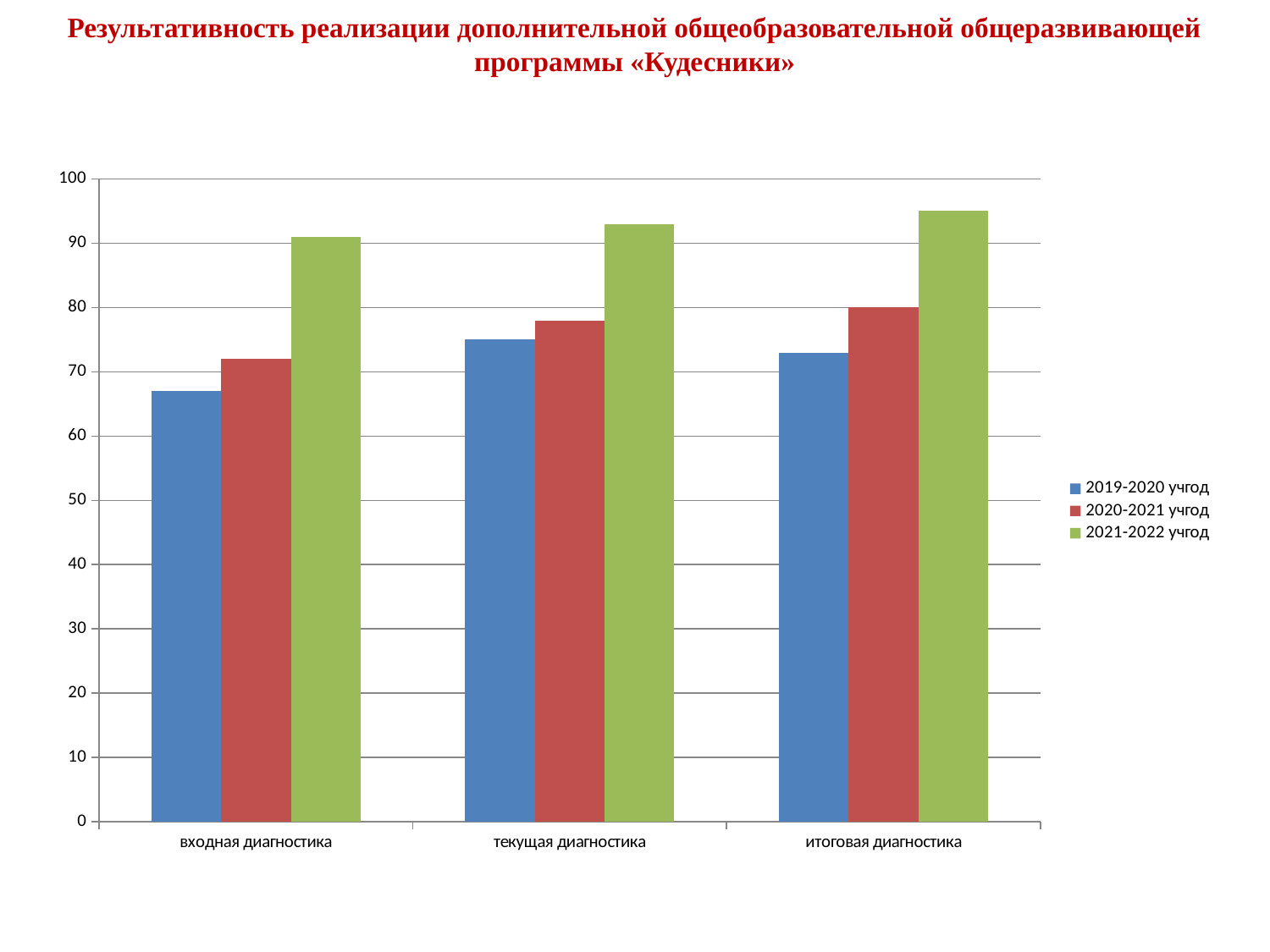
Which series has the highest value for входная диагностика? 2021-2022 учгод What kind of chart is shown on the slide? bar chart Which is larger: the 2020-2021 учгод value for итоговая диагностика or the 2019-2020 учгод value for итоговая диагностика? 2020-2021 учгод Is the value for 2019-2020 учгод at входная диагностика greater or less than 70? less How many categories are shown on the x axis? 3 Is the value for 2020-2021 учгод at текущая диагностика greater or less than 80? less What colour are the bars for 2021-2022 учгод? green How many series does the legend list? 3 Which is larger: the 2019-2020 учгод value for текущая диагностика or the 2019-2020 учгод value for входная диагностика? текущая диагностика Which series has the lowest value for итоговая диагностика? 2019-2020 учгод Do the values for 2021-2022 учгод rise or fall from входная диагностика to итоговая диагностика? rise